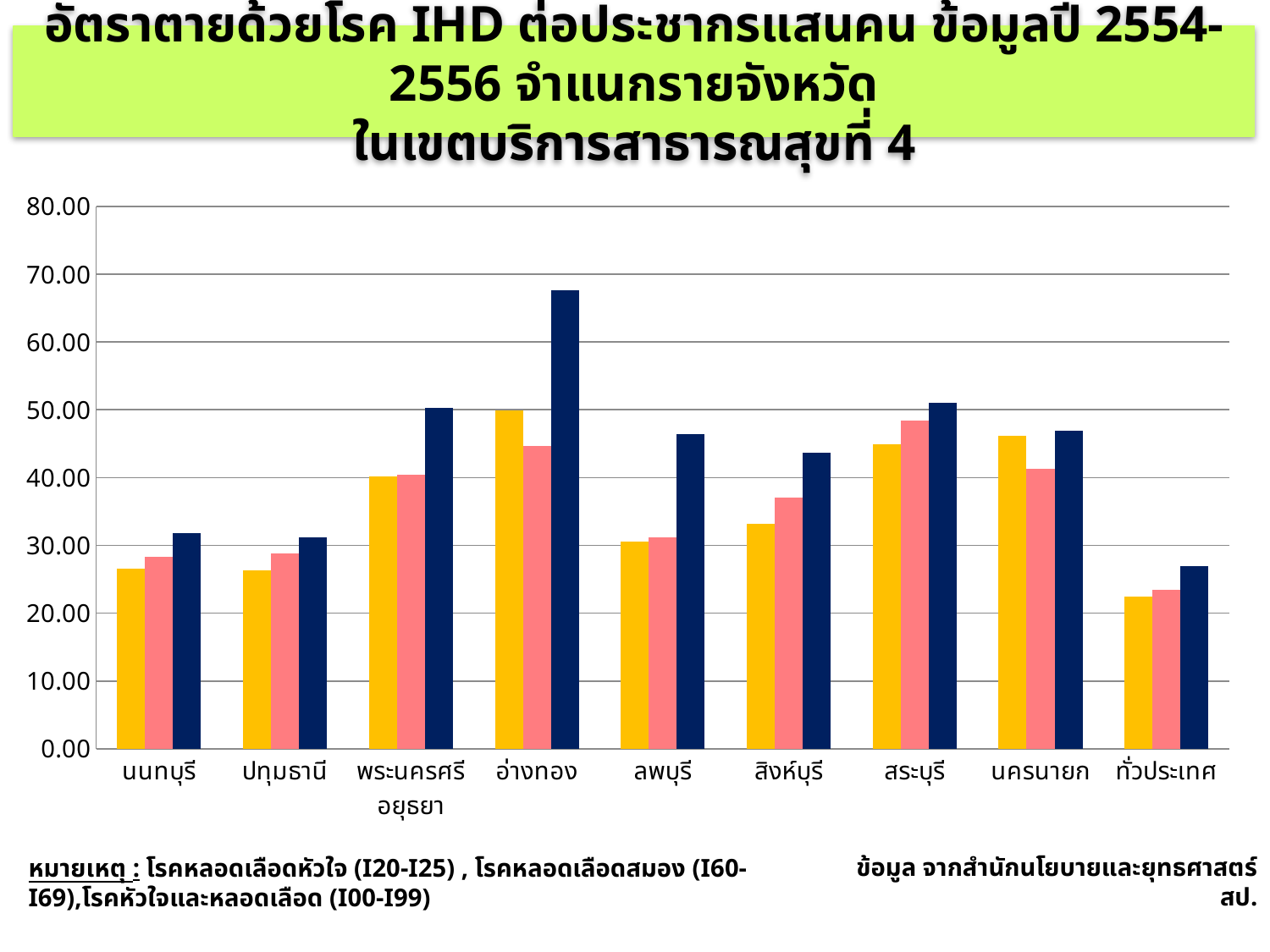
Which category has the tallest pink bar? สระบุรี Which category has the shortest yellow bar? ทั่วประเทศ Which category has the tallest dark blue bar? อ่างทอง Is the dark blue bar for อ่างทอง greater or less than 60.00? greater What kind of chart is shown on the slide? bar chart Is the pink bar for ปทุมธานี greater or less than 30.00? less Which is larger, the yellow bar for อ่างทอง or the yellow bar for นนทบุรี? อ่างทอง Which is larger, the dark blue bar for อ่างทอง or the dark blue bar for สระบุรี? อ่างทอง How many categories are shown along the x axis of the chart? 9 How many bars are plotted for each category on the chart? 3 Is the dark blue bar for ลพบุรี greater or less than 40.00? greater